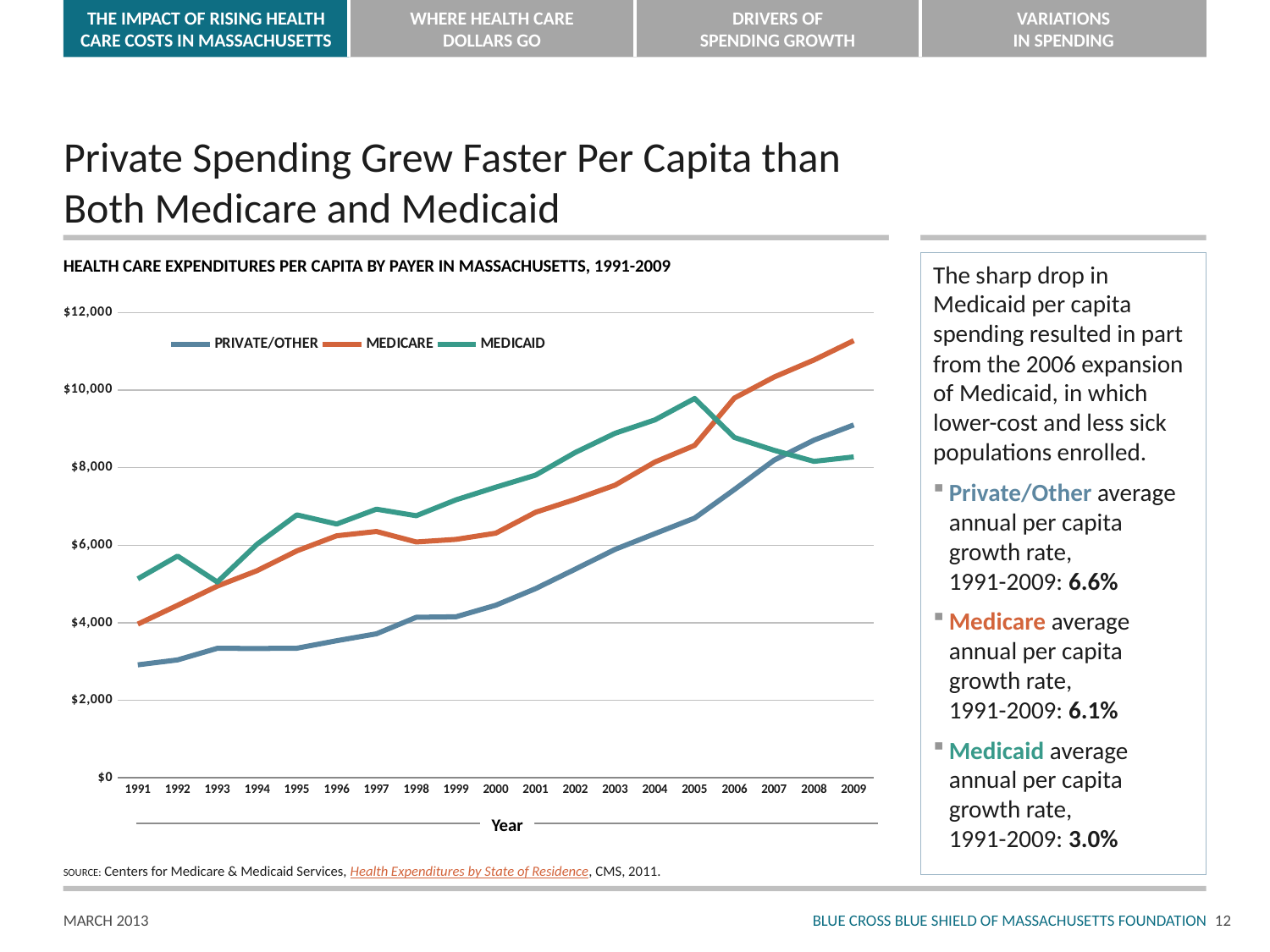
In 2005, which is larger: the value for Medicaid or the value for Medicare? Medicaid Which series has the lowest value in 1991? Private/Other What is the title of the chart? Health Care Expenditures Per Capita by Payer in Massachusetts, 1991-2009 How many years are plotted along the x axis? 19 Is the value for Private/Other in 1991 greater or less than $4,000? less Is the value for Medicare in 1991 greater or less than $6,000? less How many series does the legend list? 3 Which series has the highest value in 2009? Medicare Is the value for Medicare in 2009 greater or less than $10,000? greater What kind of chart is shown on the slide? Line chart Does the Private/Other series rise or fall from 1991 to 2009? rise